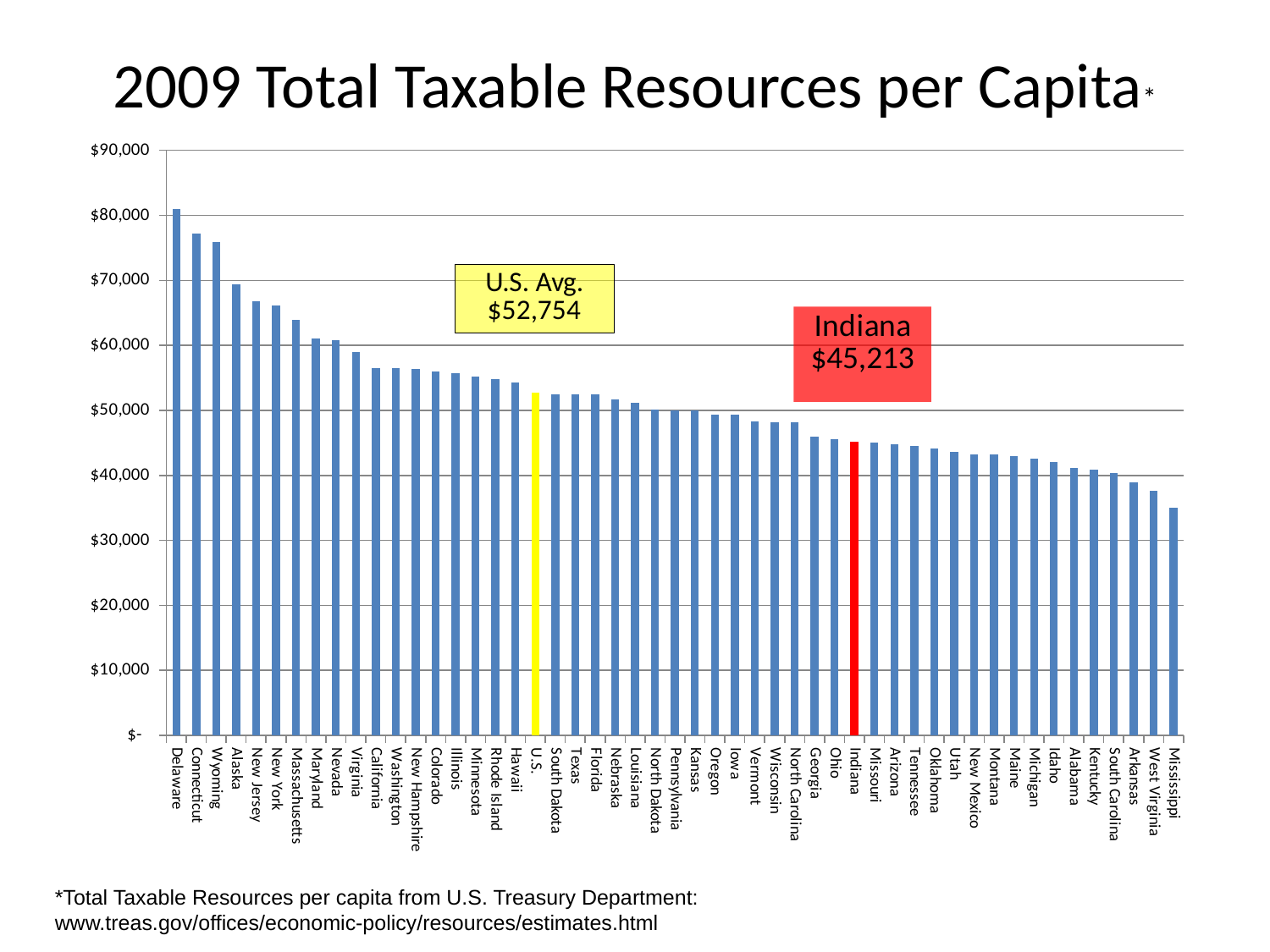
Is the value for Connecticut greater or less than $70,000? greater Is the value for New York greater or less than $60,000? greater What is the U.S. average value shown on the chart? $52,754 What kind of chart is shown on the slide? bar chart Is the value for Mississippi greater or less than $40,000? less How much lower is Indiana's value than the U.S. average? $7,541 Do the values rise or fall moving from left to right along the x axis? fall What is the value shown for Indiana? $45,213 Which is larger, the value for Indiana or the U.S. average? U.S. average Which state has the lowest total taxable resources per capita? Mississippi Which state has the highest total taxable resources per capita? Delaware What colour is the bar for Indiana? red